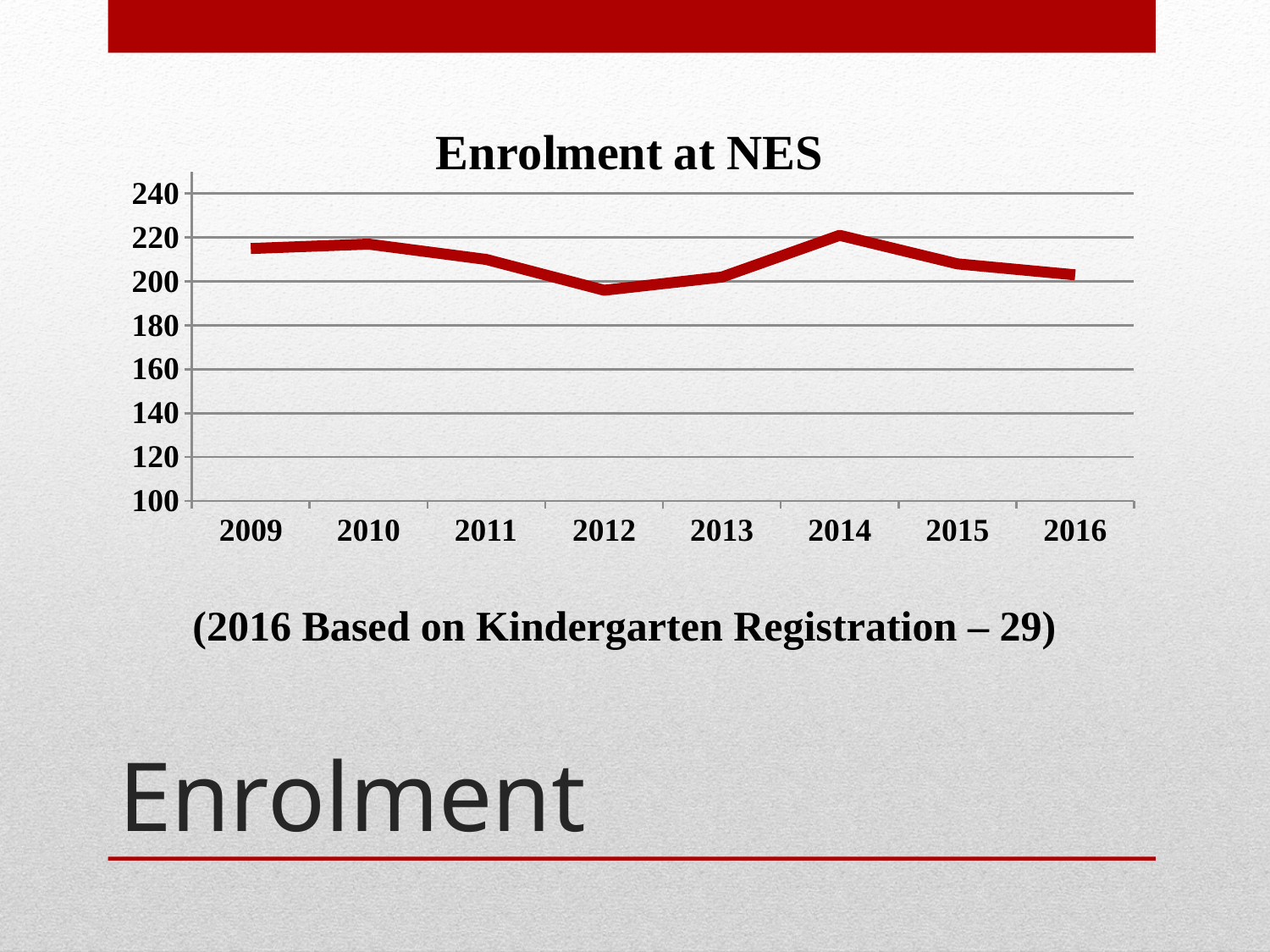
Is the enrolment value for 2009 greater or less than 200? greater Is the enrolment value for 2014 greater or less than 200? greater What kind of chart is shown on the slide? line chart Does enrolment rise or fall from 2010 to 2012? fall What is the title of the chart? Enrolment at NES Is the enrolment value for 2012 greater or less than 200? less How many years are plotted on the x axis of the chart? 8 Which year has the highest enrolment in the chart? 2014 Which year has the lowest enrolment in the chart? 2012 Does enrolment rise or fall from 2012 to 2014? rise Which year has the larger enrolment, 2012 or 2014? 2014